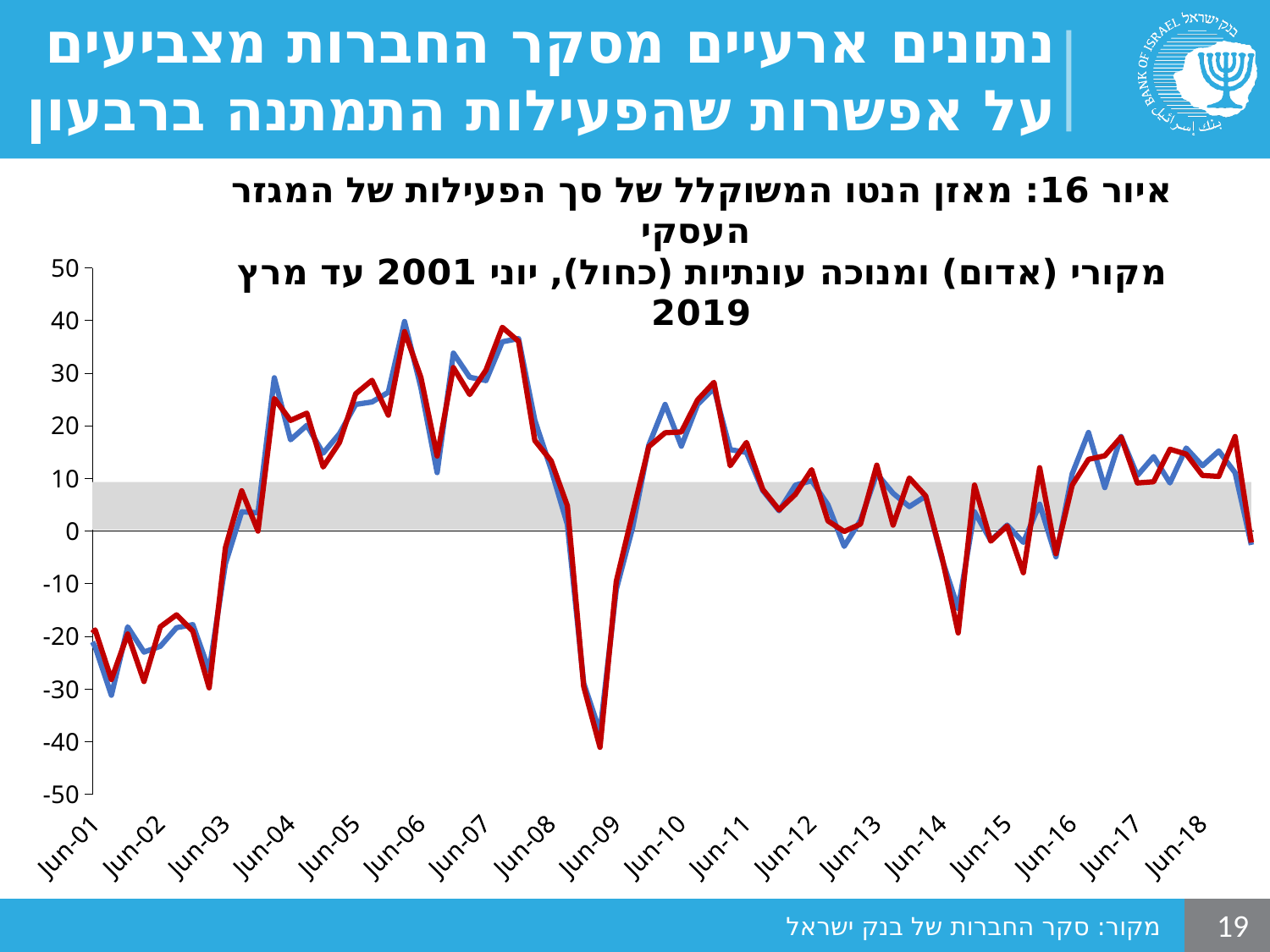
Is the value of the red line at Jun-03 greater or less than -20? greater Is the value of the red line at Jun-01 greater or less than -10? less What kind of chart is shown on the slide? line chart How many series are plotted in the chart? 2 Do the lines generally rise or fall between Jun-03 and Jun-06? rise Do the lines generally rise or fall between Jun-08 and Jun-09? fall Is the value of the blue line at Jun-10 greater or less than 10? greater What are the minimum and maximum values shown on the y axis of the chart? -50 and 50 Around which x-axis label does the red line reach its lowest point? Jun-09 How many date labels are shown along the x axis of the chart? 18